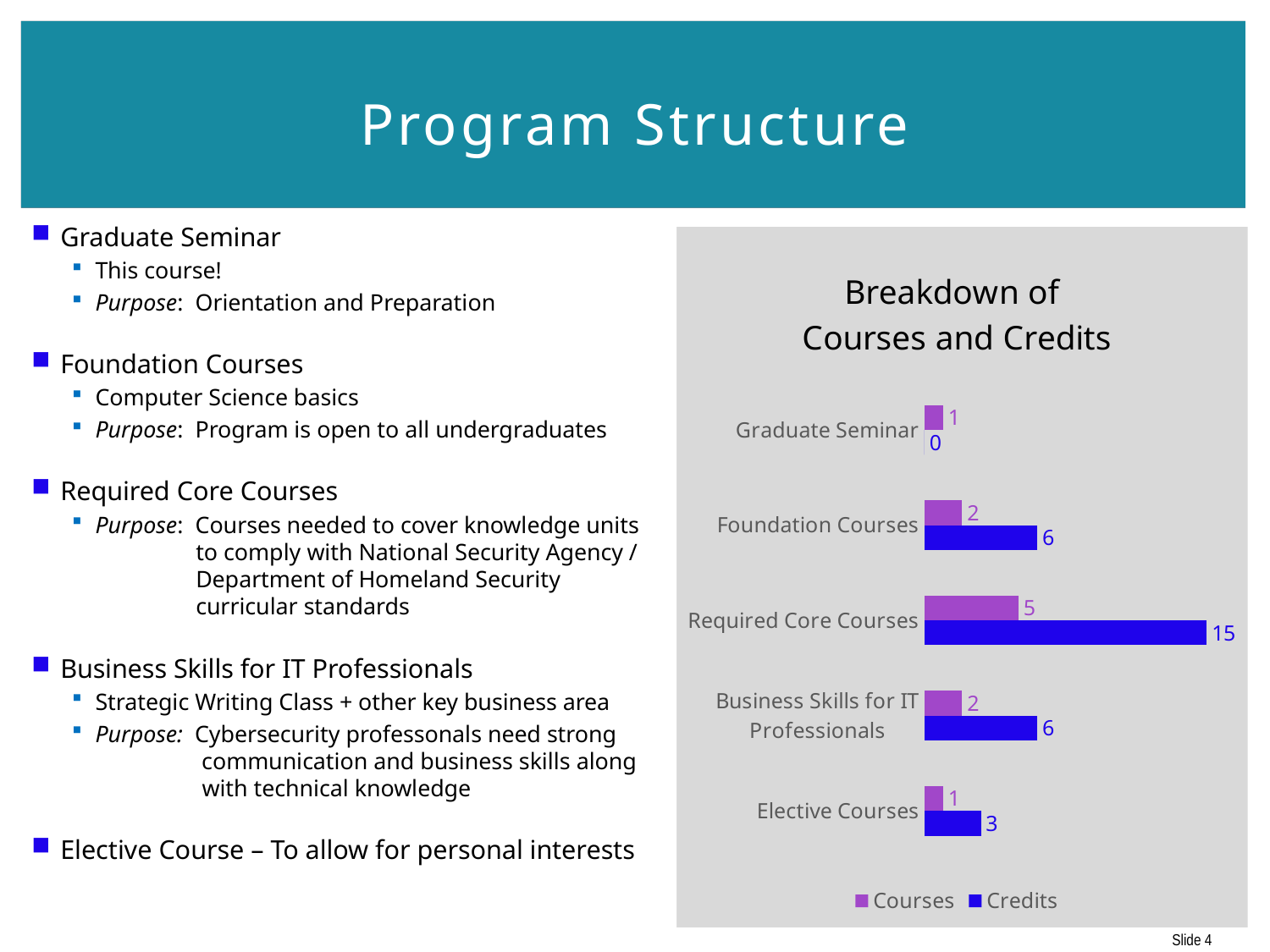
Which series is shown in blue in the legend? Credits How many credits are shown for Required Core Courses? 15 Which category has the highest number of credits? Required Core Courses How many credits are shown for Graduate Seminar? 0 Which category has the lowest number of credits? Graduate Seminar What kind of chart is shown on the slide? bar chart Which has more courses, Required Core Courses or Business Skills for IT Professionals? Required Core Courses How many series does the legend list? 2 What is the difference in credits between Required Core Courses and Elective Courses? 12 How many courses are shown for Foundation Courses? 2 What is the chart's title? Breakdown of Courses and Credits How many categories are shown in the chart? 5